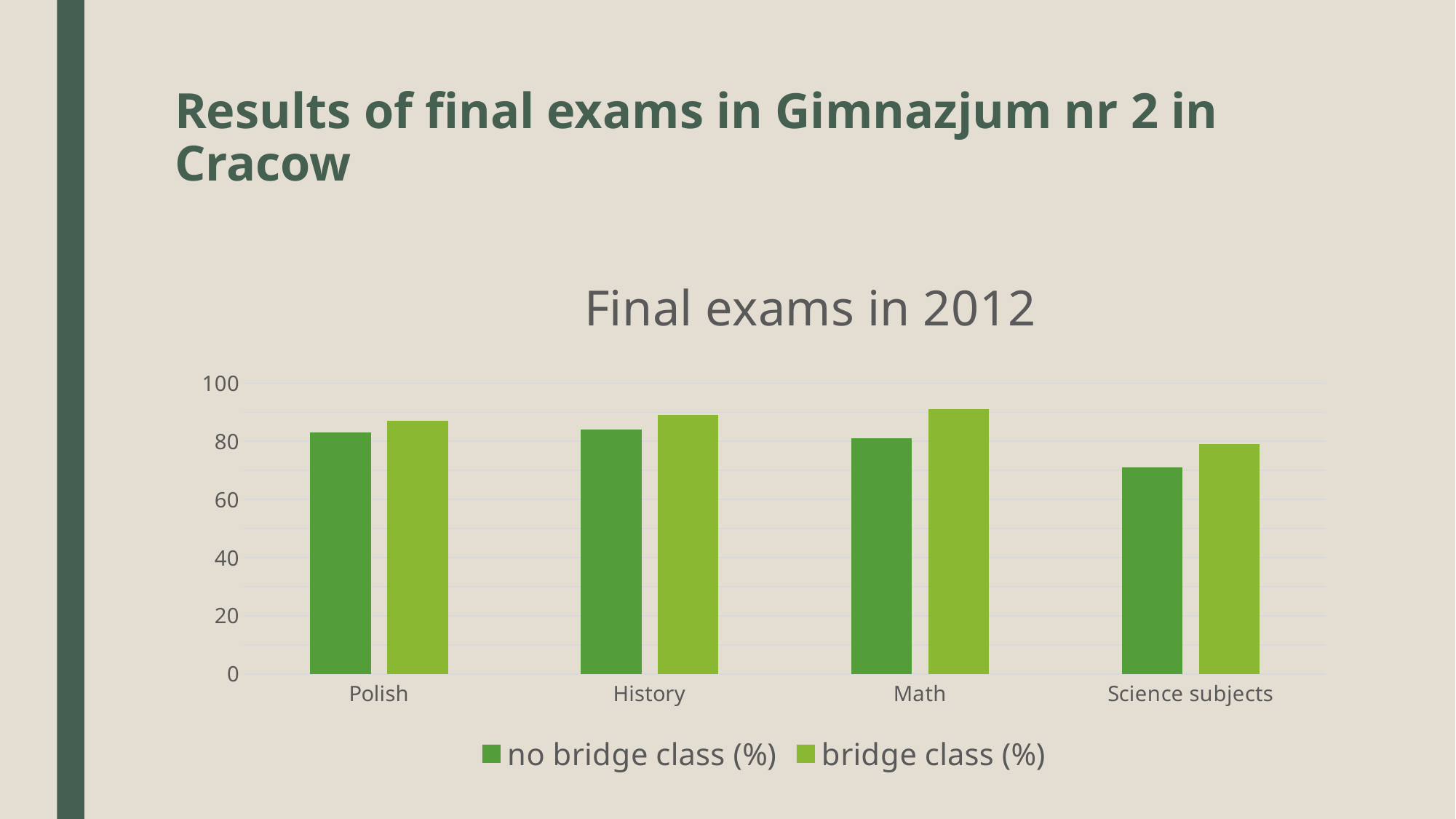
Which category has the lowest value for the no bridge class (%) series? Science subjects Is the value for no bridge class (%) in Science subjects greater or less than 80? less What kind of chart is shown on the slide? bar chart Which category has the lowest value for the bridge class (%) series? Science subjects Is the value for bridge class (%) in Math greater or less than 80? greater What is the title of the chart? Final exams in 2012 Is the value for no bridge class (%) in Science subjects greater or less than 60? greater How many series does the legend list? 2 For Math, which is larger: no bridge class (%) or bridge class (%)? bridge class (%) For Science subjects, which is larger: no bridge class (%) or bridge class (%)? bridge class (%) How many subject categories are shown on the x axis? 4 Which legend entry is shown in the lighter green colour? bridge class (%)